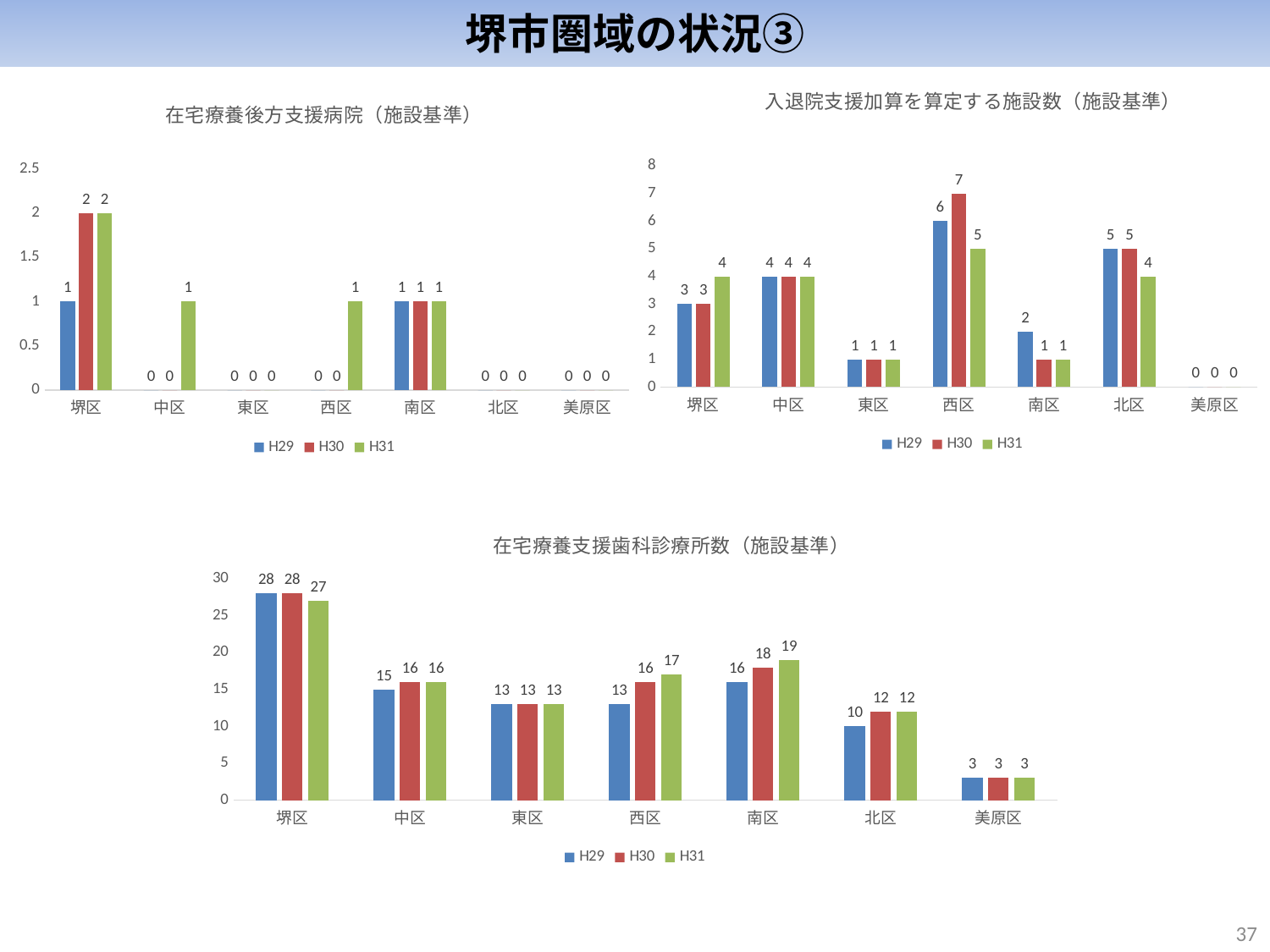
In the chart titled 在宅療養後方支援病院（施設基準）, what is the H29 value for 中区? 0 In the chart titled 入退院支援加算を算定する施設数（施設基準）, what is the difference between the H30 and H31 values for 西区? 2 In the chart titled 在宅療養支援歯科診療所数（施設基準）, do the values for 西区 rise or fall from H29 to H31? rise What kind of chart is the chart titled 在宅療養後方支援病院（施設基準）? bar chart How many series does the legend list in the chart titled 在宅療養支援歯科診療所数（施設基準）? 3 In the chart titled 入退院支援加算を算定する施設数（施設基準）, which is larger for 南区: the H29 value or the H30 value? H29 In the chart titled 在宅療養支援歯科診療所数（施設基準）, what is the H31 value for 南区? 19 In the chart titled 入退院支援加算を算定する施設数（施設基準）, which district has the highest H29 value? 西区 In the chart titled 在宅療養後方支援病院（施設基準）, what is the H31 value for 堺区? 2 In the chart titled 在宅療養支援歯科診療所数（施設基準）, what is the difference between the H29 values for 堺区 and 北区? 18 In the chart titled 入退院支援加算を算定する施設数（施設基準）, what is the H30 value for 西区? 7 In the chart titled 在宅療養支援歯科診療所数（施設基準）, which district has the lowest H30 value? 美原区